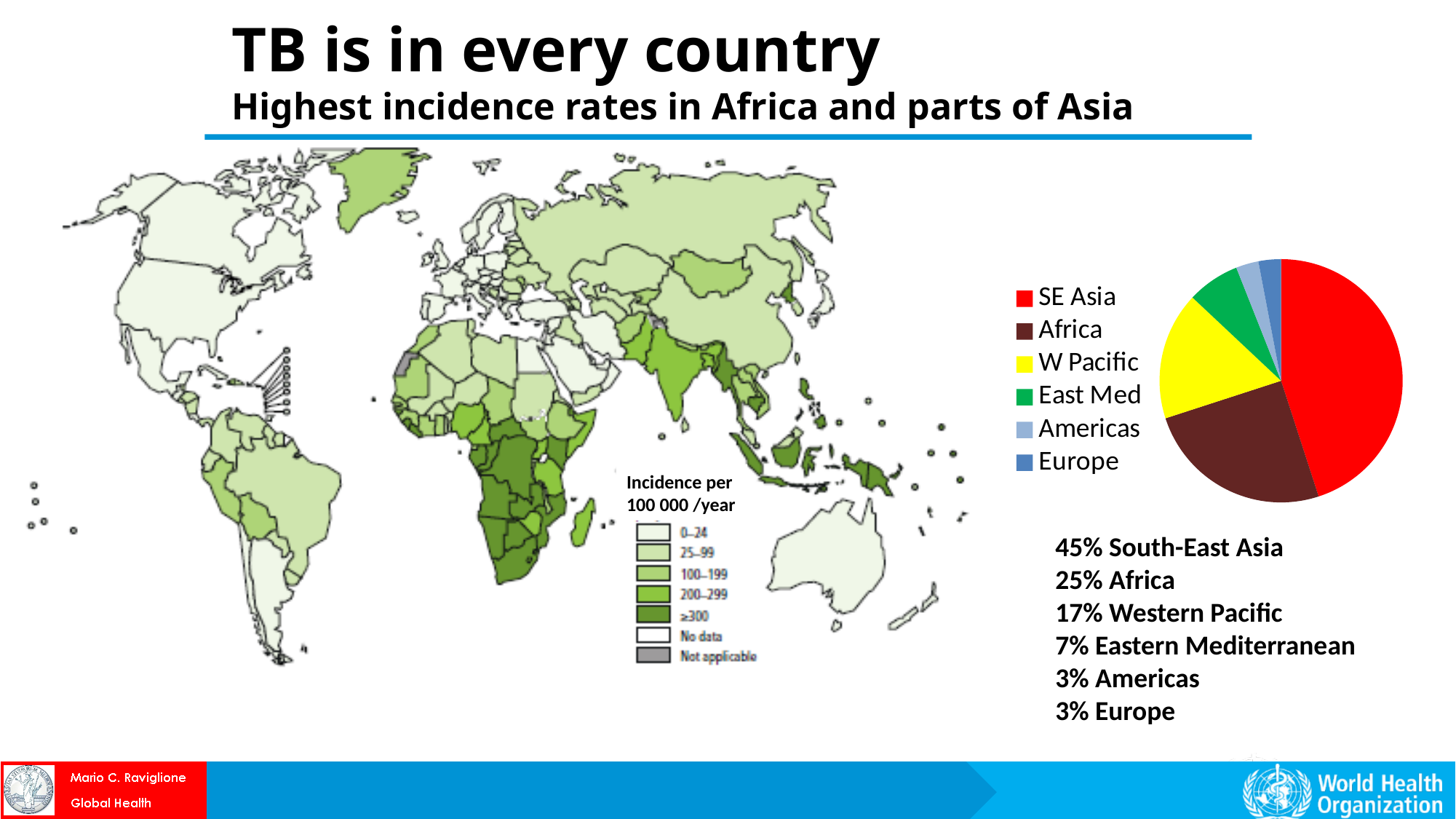
In the pie chart, which is larger: the share for W Pacific or the share for East Med? W Pacific What colour is the SE Asia slice in the pie chart? red In the pie chart, what share does the Americas account for? 3% What kind of chart is shown on the right side of the slide? pie chart Which region has the largest slice in the pie chart? SE Asia In the pie chart, what share does SE Asia account for? 45% How many entries does the pie chart legend list? 6 In the pie chart, what share does Africa account for? 25% In the pie chart, what is the difference in percentage points between the SE Asia share and the Africa share? 20 percentage points How many slices does the pie chart have? 6